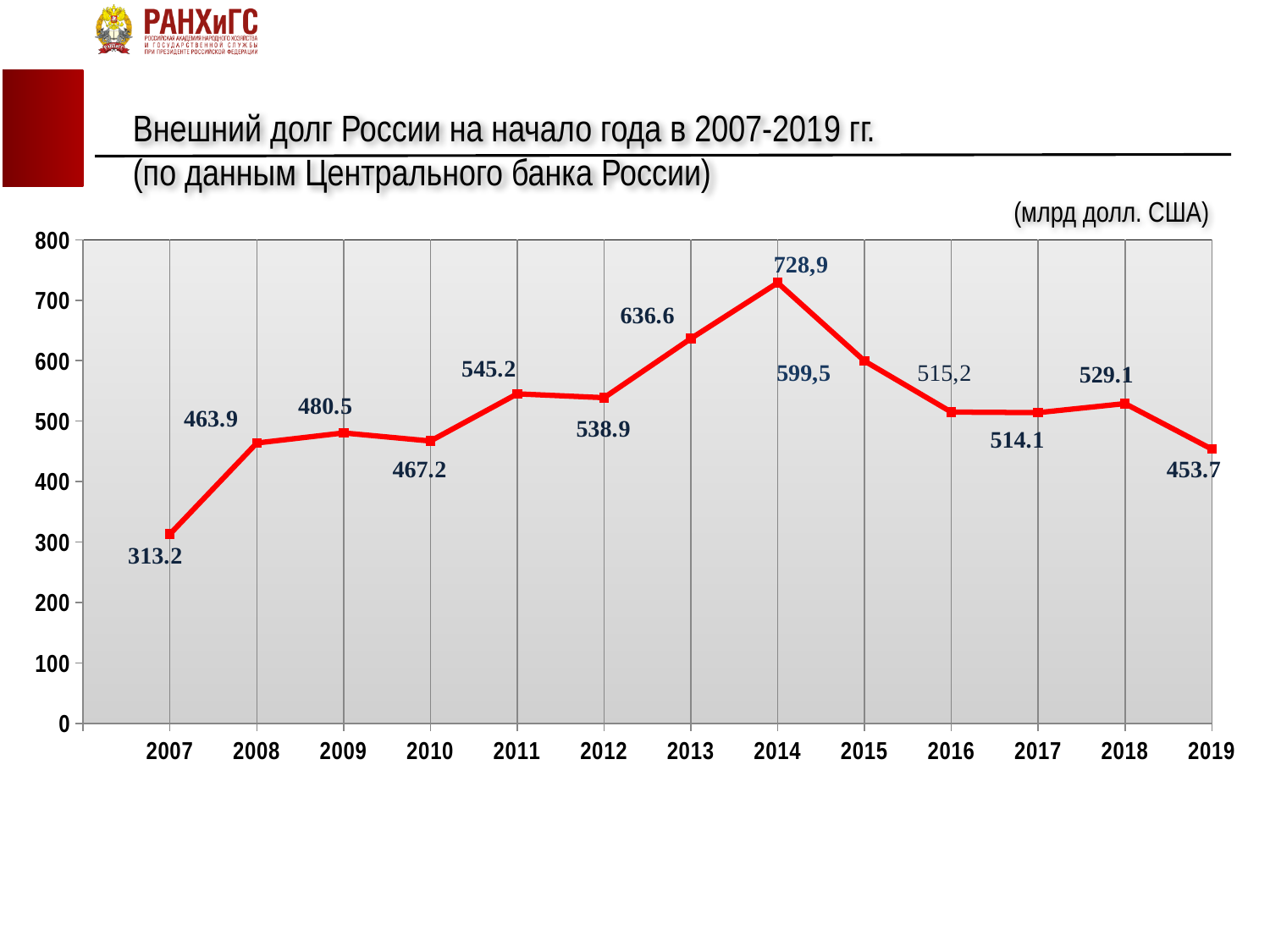
What is the value for 2013? 636.6 Which year has the lowest value? 2007 How many years are plotted on the chart? 13 Is the value for 2015 greater or less than 500? greater What is the value for 2007? 313.2 What kind of chart is shown on the slide? line chart What is the value for 2019? 453.7 Which is larger, the value for 2011 or the value for 2012? 2011 What is the difference between the values for 2014 and 2019? 275.2 What is the value for 2014? 728,9 Do the values rise or fall from 2014 to 2017? fall Which year has the highest value? 2014